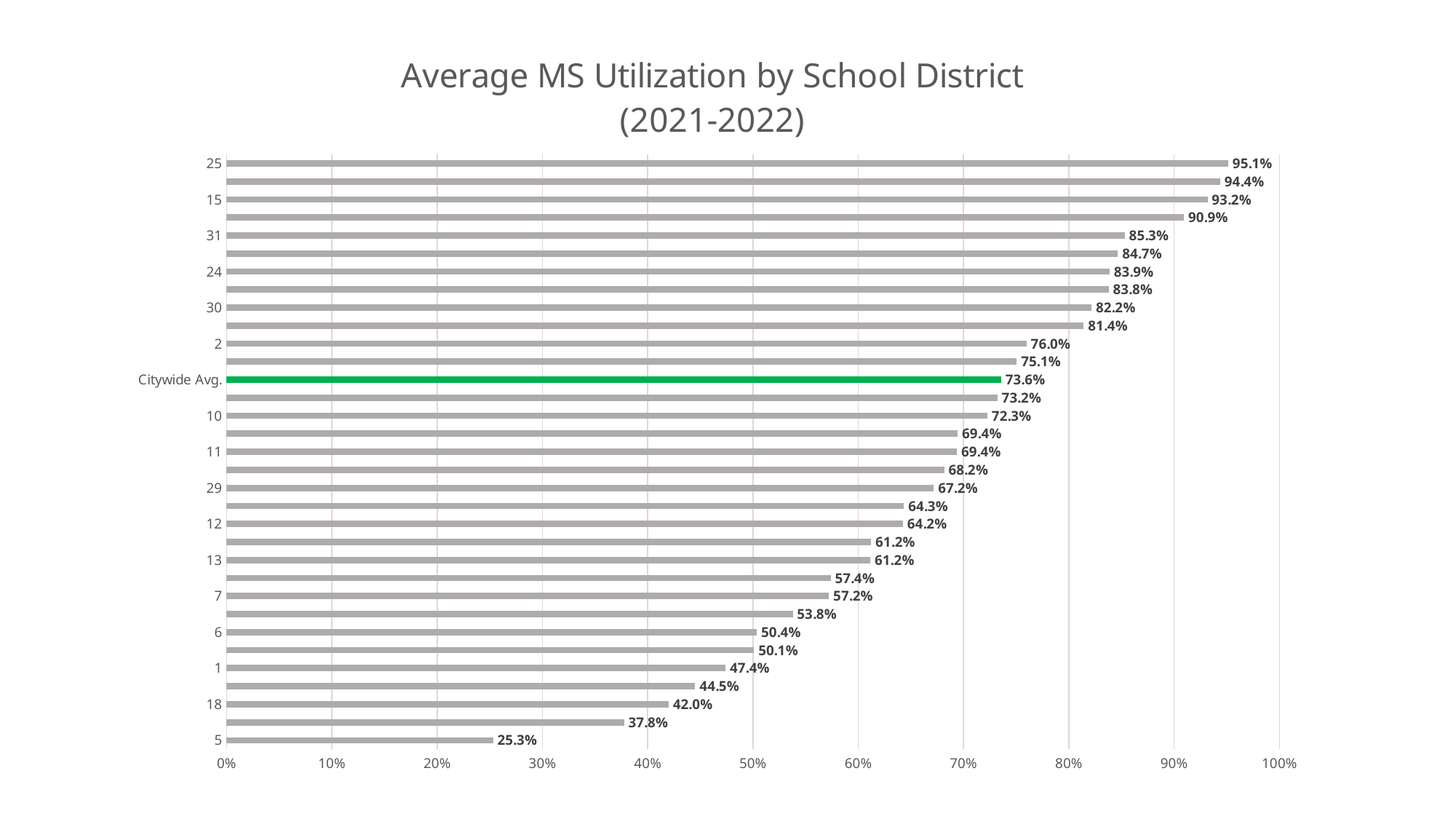
What kind of chart is shown on the slide? Bar chart What is the difference in average MS utilization between district 25 and district 5? 69.8 percentage points Which has a higher average MS utilization, district 24 or district 30? District 24 Is the value for district 31 greater or less than 80%? greater Which labeled school district has the lowest average MS utilization? 5 What is the Citywide Avg. value shown on the chart? 73.6% What colour is the Citywide Avg. bar? Green What is the average MS utilization for school district 18? 42.0% What is the average MS utilization for school district 25? 95.1% How many bars are plotted on the chart? 33 Which labeled school district has the highest average MS utilization? 25 What is the average MS utilization for school district 5? 25.3%